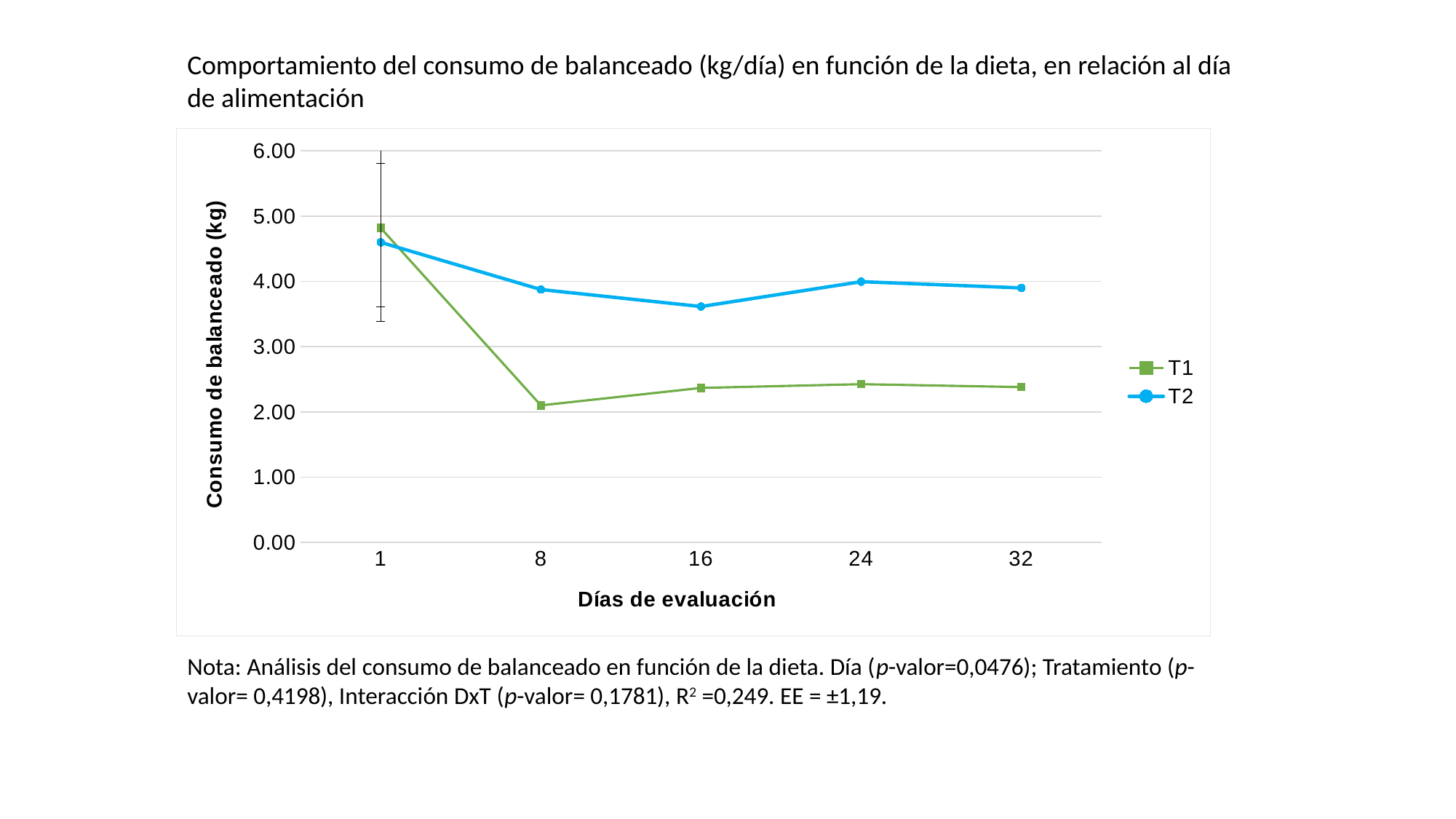
On which evaluation day does T1 reach its lowest consumption? 8 Is the value for T1 on day 8 greater or less than 3.00? less How many series does the legend list? 2 What is the title of the y axis? Consumo de balanceado (kg) How many evaluation days are plotted along the x axis? 5 Does the T1 line rise or fall between day 1 and day 8? fall Is the value for T1 on day 1 greater or less than 4.00? greater On which evaluation day does T2 reach its lowest consumption? 16 Which series has the higher value on day 8, T1 or T2? T2 What kind of chart is shown on the slide? line chart On which evaluation day does T1 reach its highest consumption? 1 Is the value for T2 on day 16 greater or less than 3.00? greater